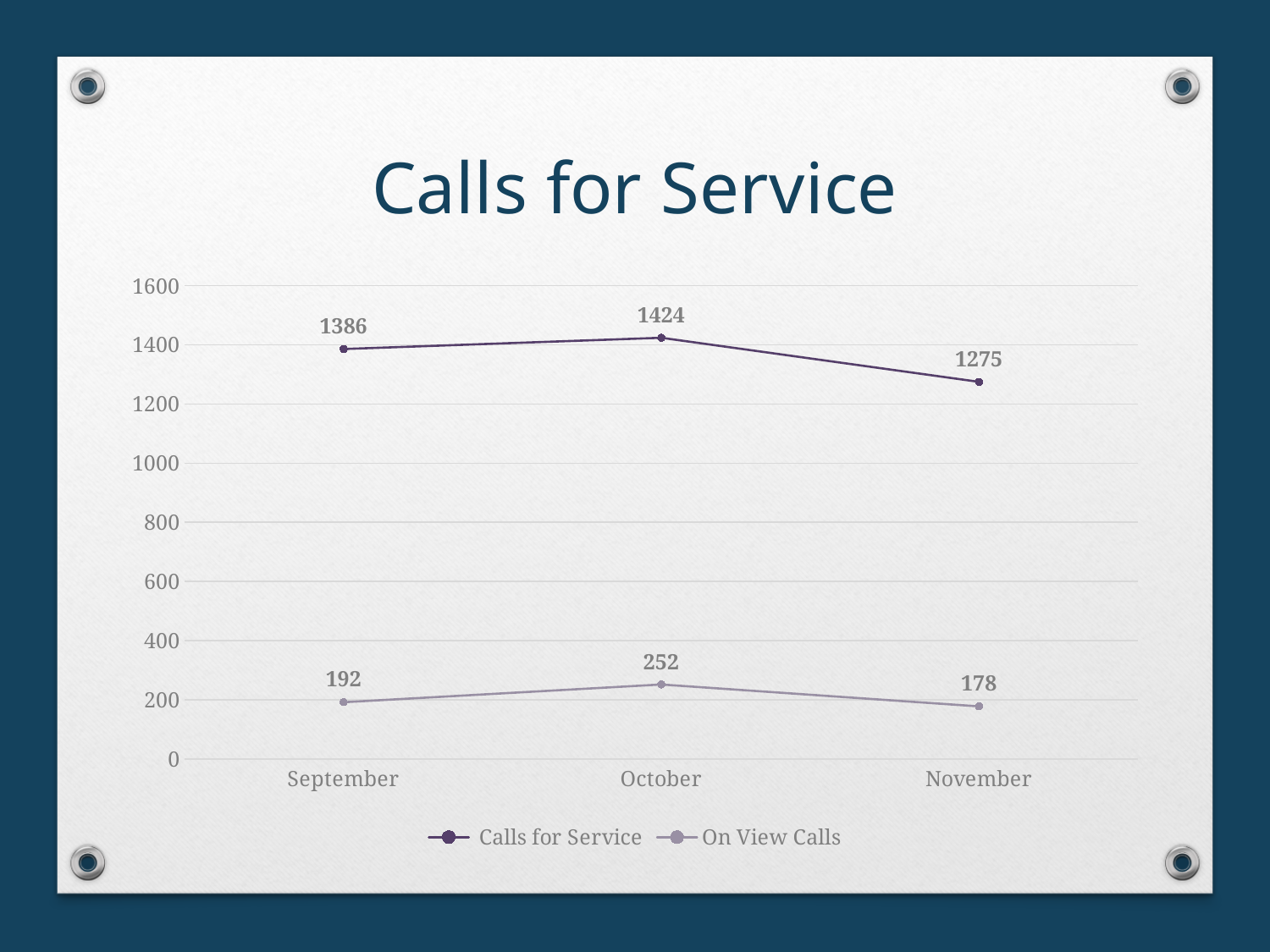
In which month is On View Calls lowest? November In which month is Calls for Service highest? October What is the value for On View Calls in November? 178 Which is larger: Calls for Service in September or in November? September What kind of chart is shown on the slide? line chart What is the difference between Calls for Service in October and November? 149 How many series does the legend list? 2 What is the value for Calls for Service in September? 1386 How many months are shown on the x axis? 3 What is the value for Calls for Service in October? 1424 Is the value for On View Calls in October greater or less than 200? greater What is the difference between On View Calls in October and September? 60